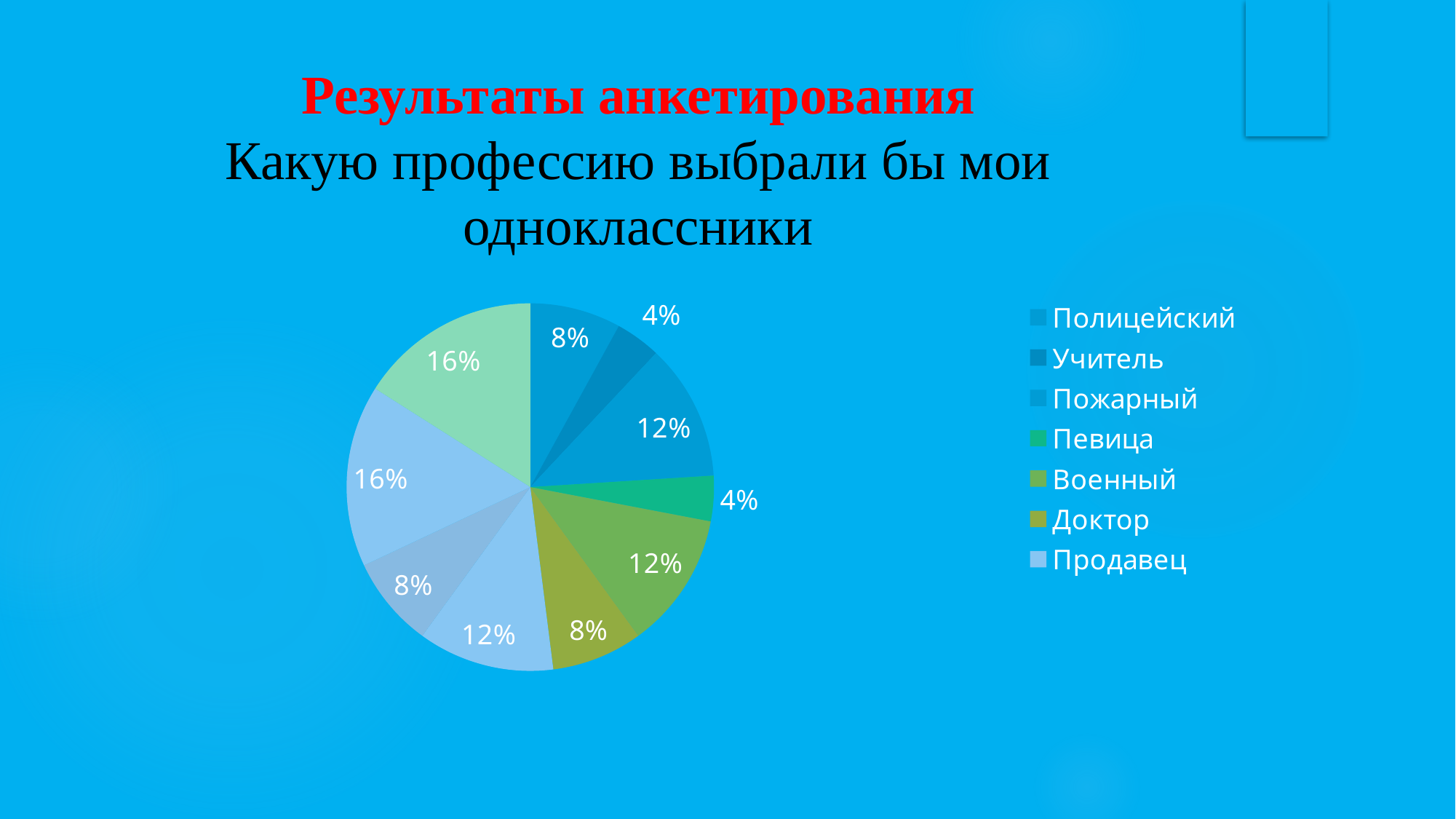
How many slices of the pie chart are labelled 12%? 3 What kind of chart is shown on the slide? pie chart How many entries does the legend of the pie chart list? 7 How many slices of the pie chart are labelled 8%? 3 What is the difference between the largest slice value (16%) and the smallest slice value (4%) in the pie chart? 12% How many slices does the pie chart have? 10 What is the smallest percentage shown on any slice of the pie chart? 4% What is the first entry listed in the legend of the pie chart? Полицейский What is the last entry listed in the legend of the pie chart? Продавец What is the largest percentage shown on any slice of the pie chart? 16%